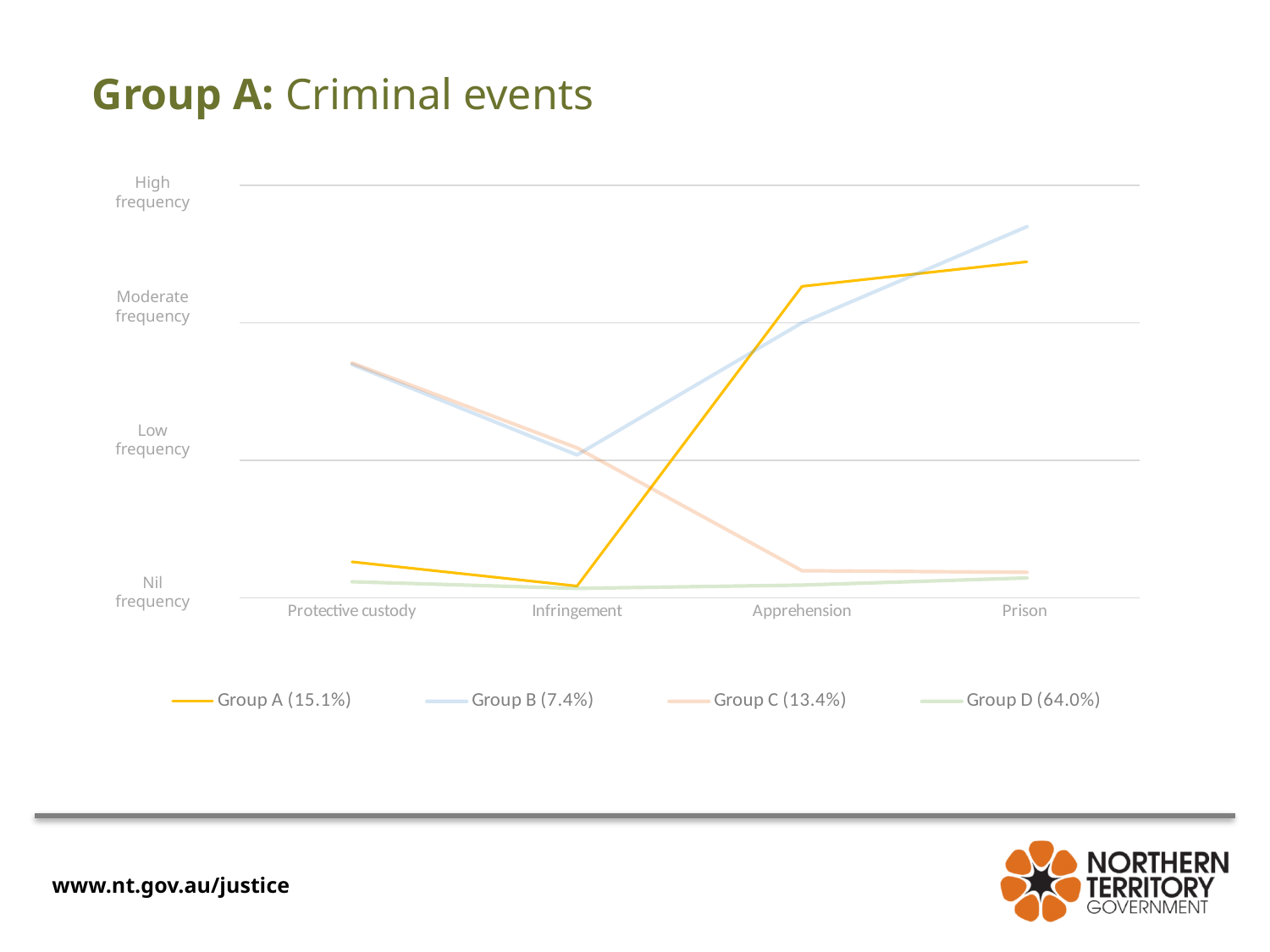
What percentage is shown next to Group D in the legend? 64.0% How many series does the legend list? 4 Does the Group C line rise or fall from Protective custody to Apprehension? fall Does the Group A line rise or fall from Infringement to Apprehension? rise What percentage is shown next to Group A in the legend? 15.1% Which series has the lowest value at Protective custody? Group D (64.0%) For which category does the Group A line reach its lowest point? Infringement Is the Group A value at Prison higher or lower than the Group C value at Prison? higher How many categories are shown on the x axis? 4 For which category does the Group A line reach its highest point? Prison What kind of chart is shown on the slide? line chart Which series has the highest value at Prison? Group B (7.4%)